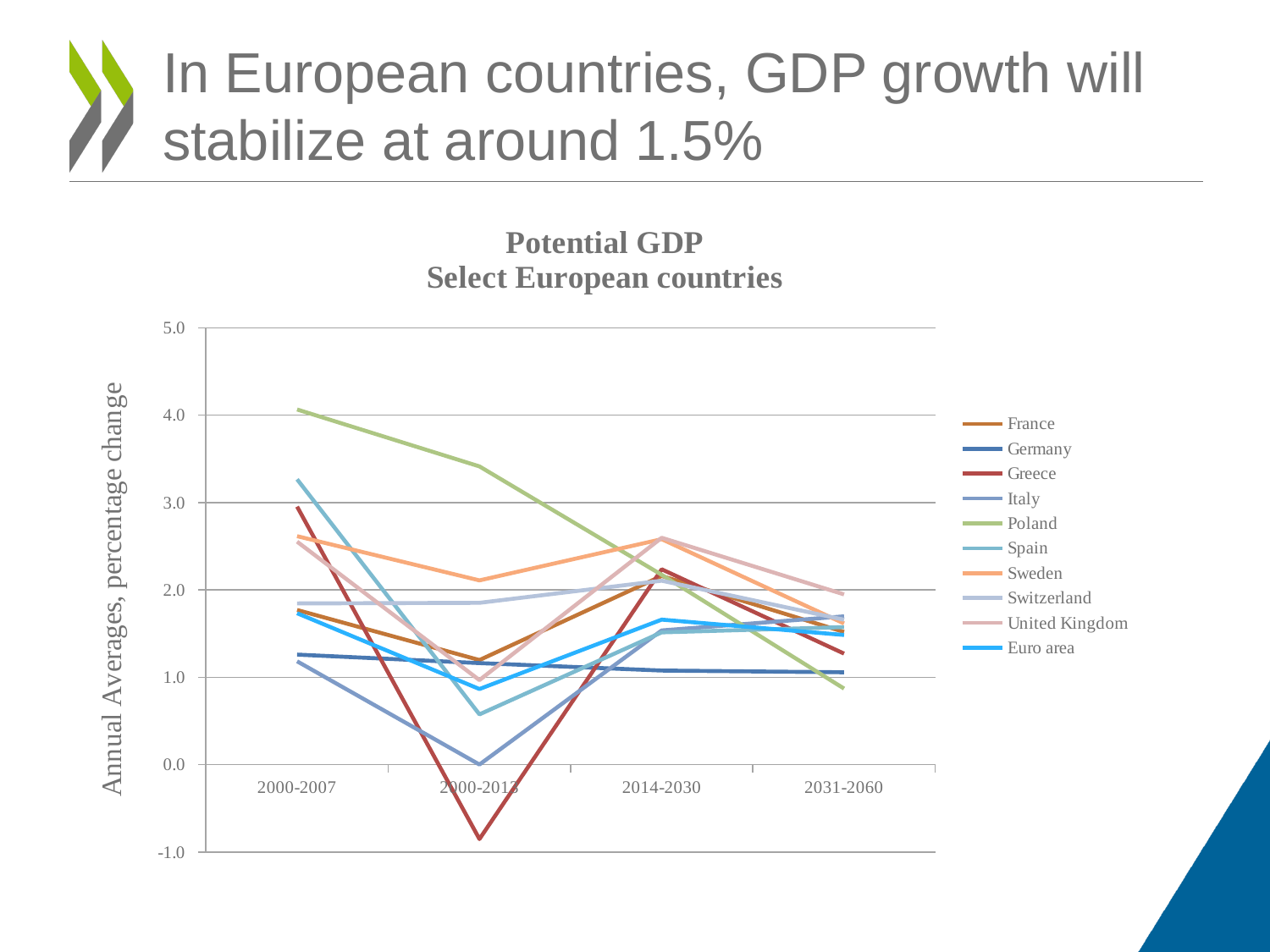
Which country has the highest potential GDP growth in 2000-2007? Poland Is the value for Poland in 2000-2007 greater or less than 3.0? greater What kind of chart is shown on the slide? line chart Which series has the highest value in 2031-2060? United Kingdom Is the value for Spain in 2000-2007 greater or less than 3.0? greater How many series does the legend list? 10 What is the label on the vertical axis? Annual Averages, percentage change Does the line for Poland rise or fall across the periods from 2000-2007 to 2031-2060? fall How many time periods are shown on the x axis? 4